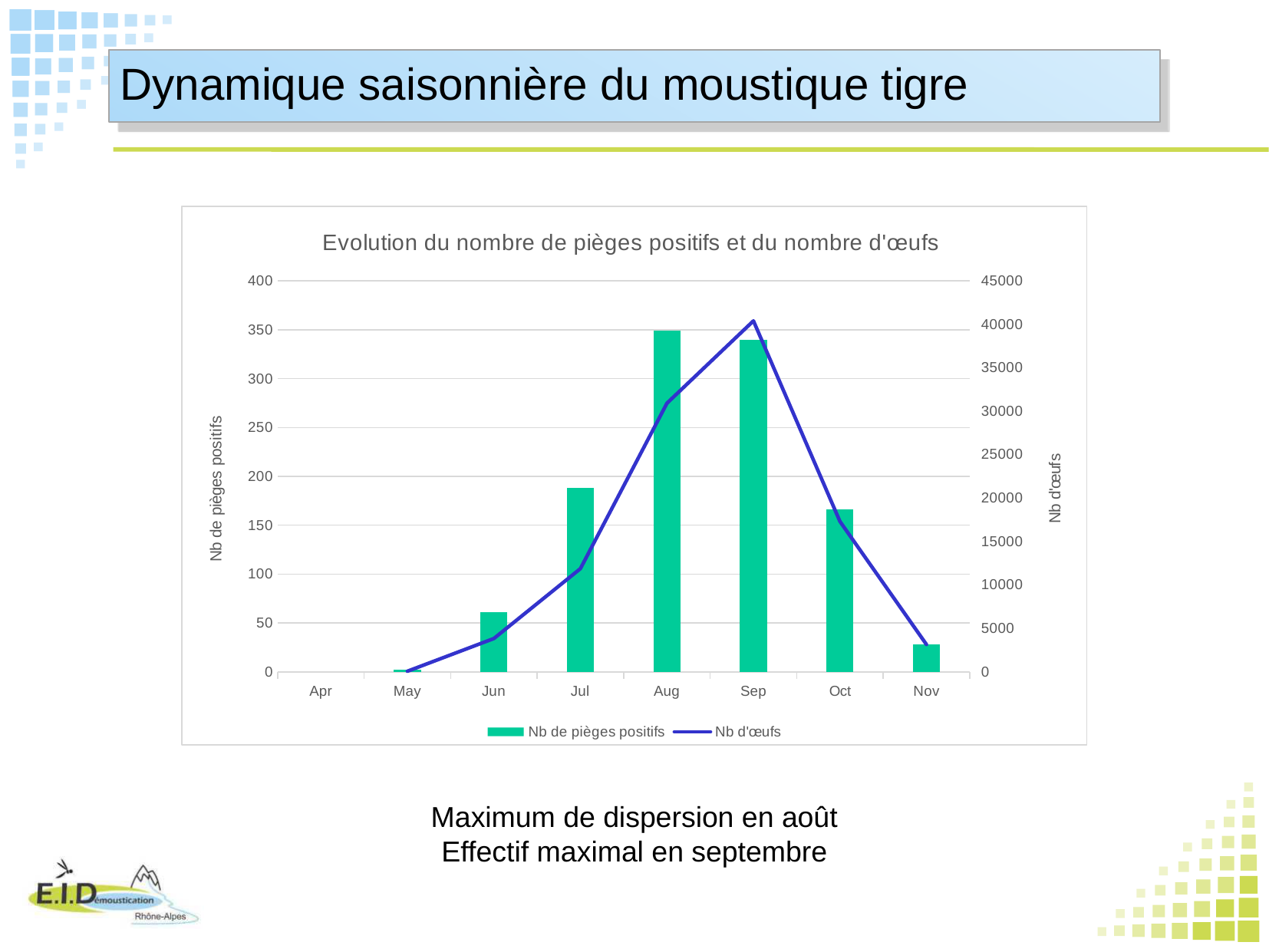
What is the title of the chart? Evolution du nombre de pièges positifs et du nombre d'œufs How many series does the chart legend list? 2 Which month has the highest bar for 'Nb de pièges positifs'? Aug Which month has the highest number of 'Nb d'œufs' (the line series)? Sep Is the 'Nb d'œufs' value for Jul greater or less than 10000? greater Is the 'Nb de pièges positifs' value for Nov greater or less than 50? less What kind of chart is shown on the slide? Combined bar and line chart Is the 'Nb de pièges positifs' value for Jul greater or less than 150? greater How many months are shown on the x axis of the chart? 8 Which month has the larger 'Nb de pièges positifs' bar, Jul or Oct? Jul How does the 'Nb d'œufs' line change from Sep to Nov? It falls